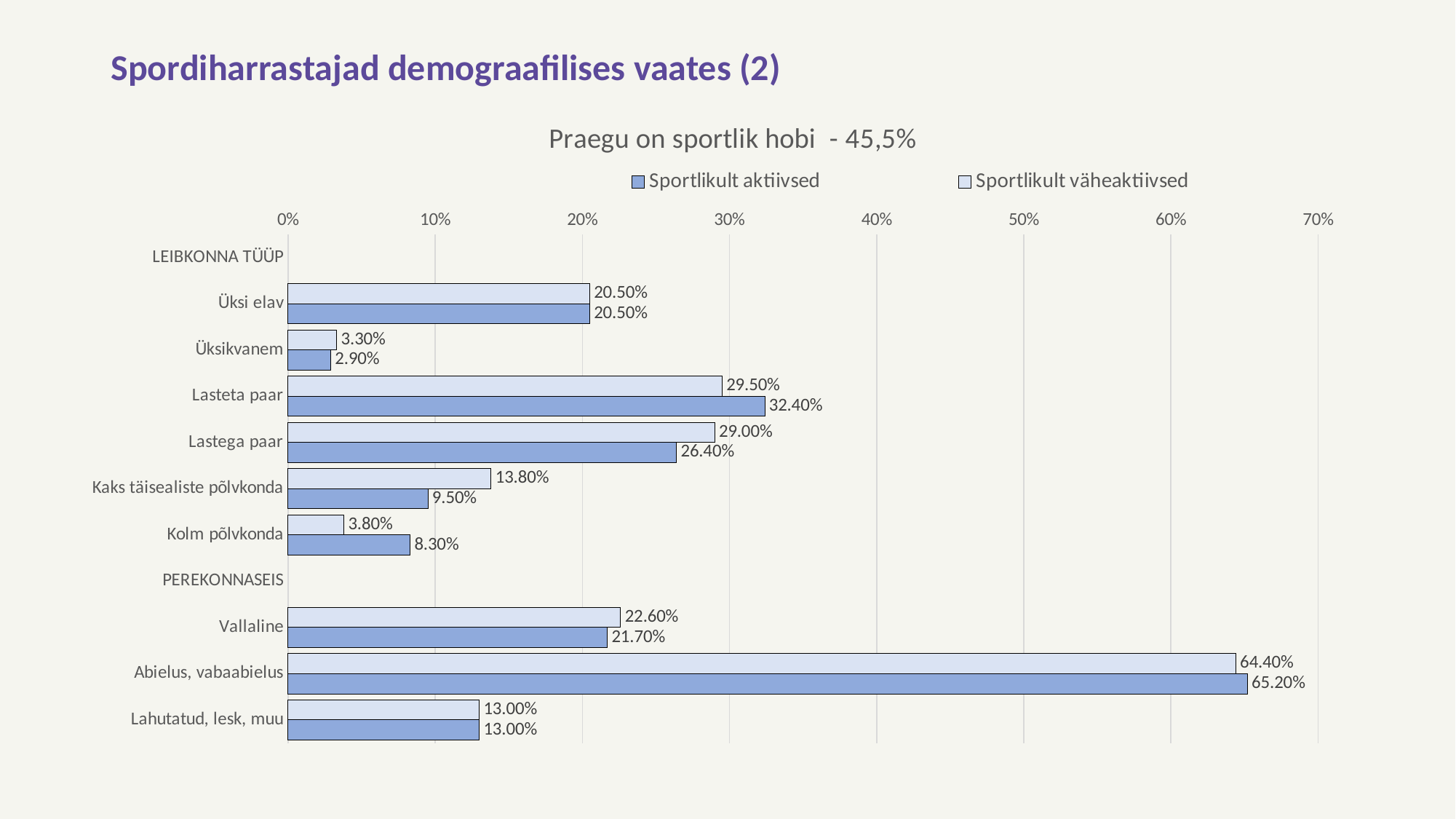
What is the difference between the Sportlikult väheaktiivsed and Sportlikult aktiivsed values for Kaks täisealiste põlvkonda? 4.30% Which category has the highest value for Sportlikult aktiivsed? Abielus, vabaabielus How many series does the legend list? 2 What is the value for Sportlikult aktiivsed in the Lasteta paar category? 32.40% Which category has the lowest value for Sportlikult aktiivsed? Üksikvanem What kind of chart is shown on the slide? Bar chart What is the value for Sportlikult väheaktiivsed in the Kaks täisealiste põlvkonda category? 13.80% What is the title of the chart? Praegu on sportlik hobi - 45,5% Which is larger for Lastega paar: the Sportlikult aktiivsed value or the Sportlikult väheaktiivsed value? Sportlikult väheaktiivsed Is the Sportlikult aktiivsed value for Abielus, vabaabielus greater or less than 60%? greater What is the value for Sportlikult aktiivsed in the Kolm põlvkonda category? 8.30% What is the value for Sportlikult väheaktiivsed in the Vallaline category? 22.60%